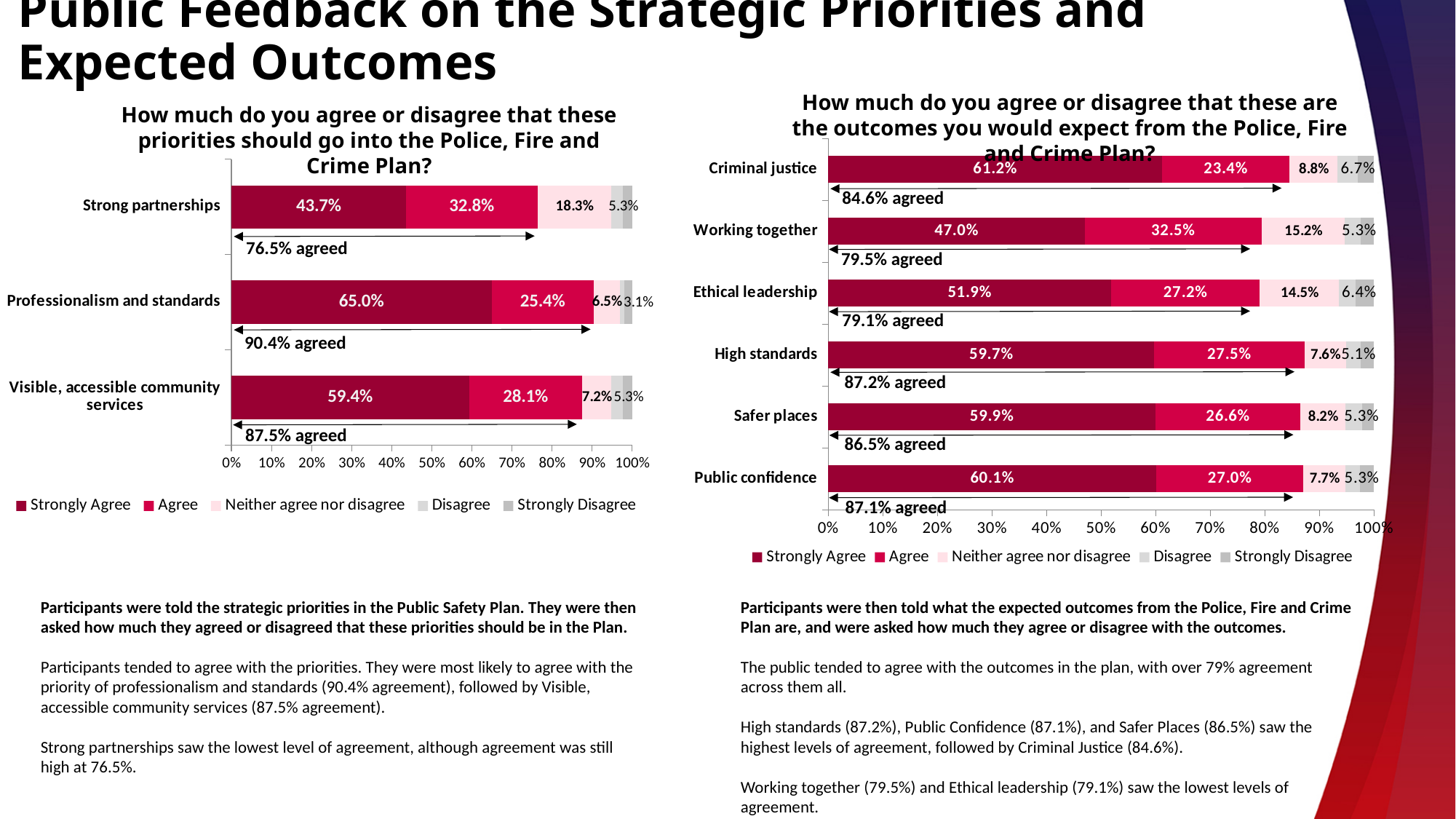
In the right chart on expected outcomes, which has a larger Neither agree nor disagree percentage: Criminal justice or Ethical leadership? Ethical leadership In the left chart on priorities for the Police, Fire and Crime Plan, what percentage of participants strongly agreed with Professionalism and standards? 65.0% In the right chart on expected outcomes, what percentage of participants agreed (not strongly) with Working together? 32.5% In the left chart on priorities, what is the combined Strongly Agree and Agree percentage for Strong partnerships? 76.5% How many series does the legend of the left chart on priorities list? 5 In the left chart on priorities, what is the Neither agree nor disagree percentage for Visible, accessible community services? 7.2% How many outcomes are shown in the right chart on expected outcomes? 6 What type of chart is the right chart on expected outcomes? Stacked bar chart In the left chart on priorities, what is the difference in percentage points between the Strongly Agree values for Professionalism and standards and Strong partnerships? 21.3 percentage points In the right chart on expected outcomes, which outcome has the lowest Strongly Agree percentage? Working together In the left chart on priorities, which priority has the highest Strongly Agree percentage? Professionalism and standards